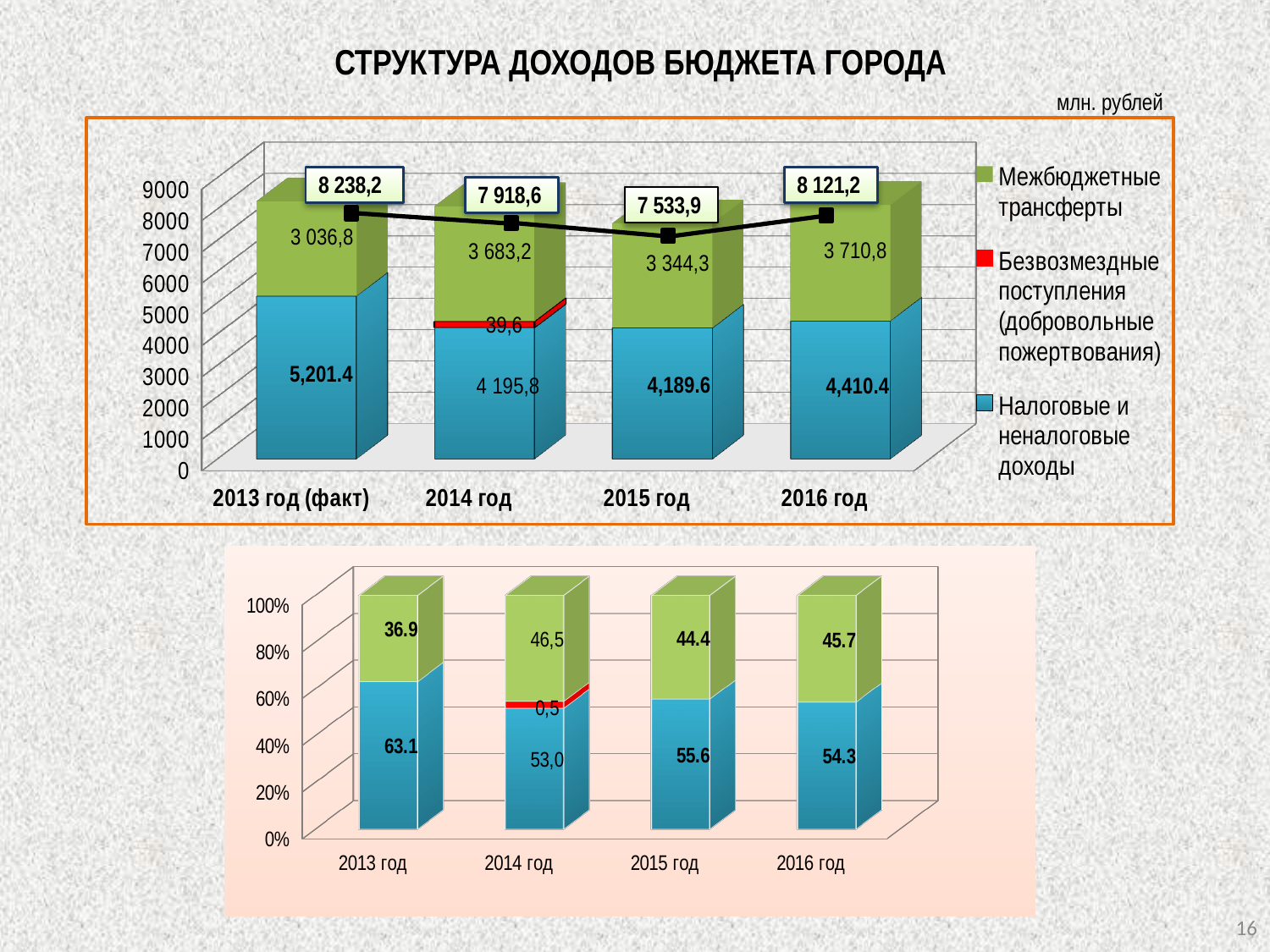
How many years are shown on the x axis of the bottom chart? 4 In the top chart, which year has the highest total shown above the bars? 2013 год (факт) In the top chart, which year has the lowest value of Налоговые и неналоговые доходы? 2015 год In the top chart, what is the value of Безвозмездные поступления (добровольные пожертвования) for 2014 год? 39,6 How many series does the legend of the top chart list? 3 In the top chart, what is the total shown above the bar for 2015 год? 7 533,9 In the bottom chart, what is the share of Межбюджетные трансферты for 2014 год? 46,5 In the top chart, is the value of Межбюджетные трансферты for 2014 год larger or smaller than for 2015 год? larger In the bottom chart, what is the share of Налоговые и неналоговые доходы for 2015 год? 55.6 In the top chart, what is the value of Межбюджетные трансферты for 2016 год? 3 710,8 In the top chart, what is the value of Налоговые и неналоговые доходы for 2013 год (факт)? 5,201.4 What kind of chart is the bottom chart? stacked bar chart